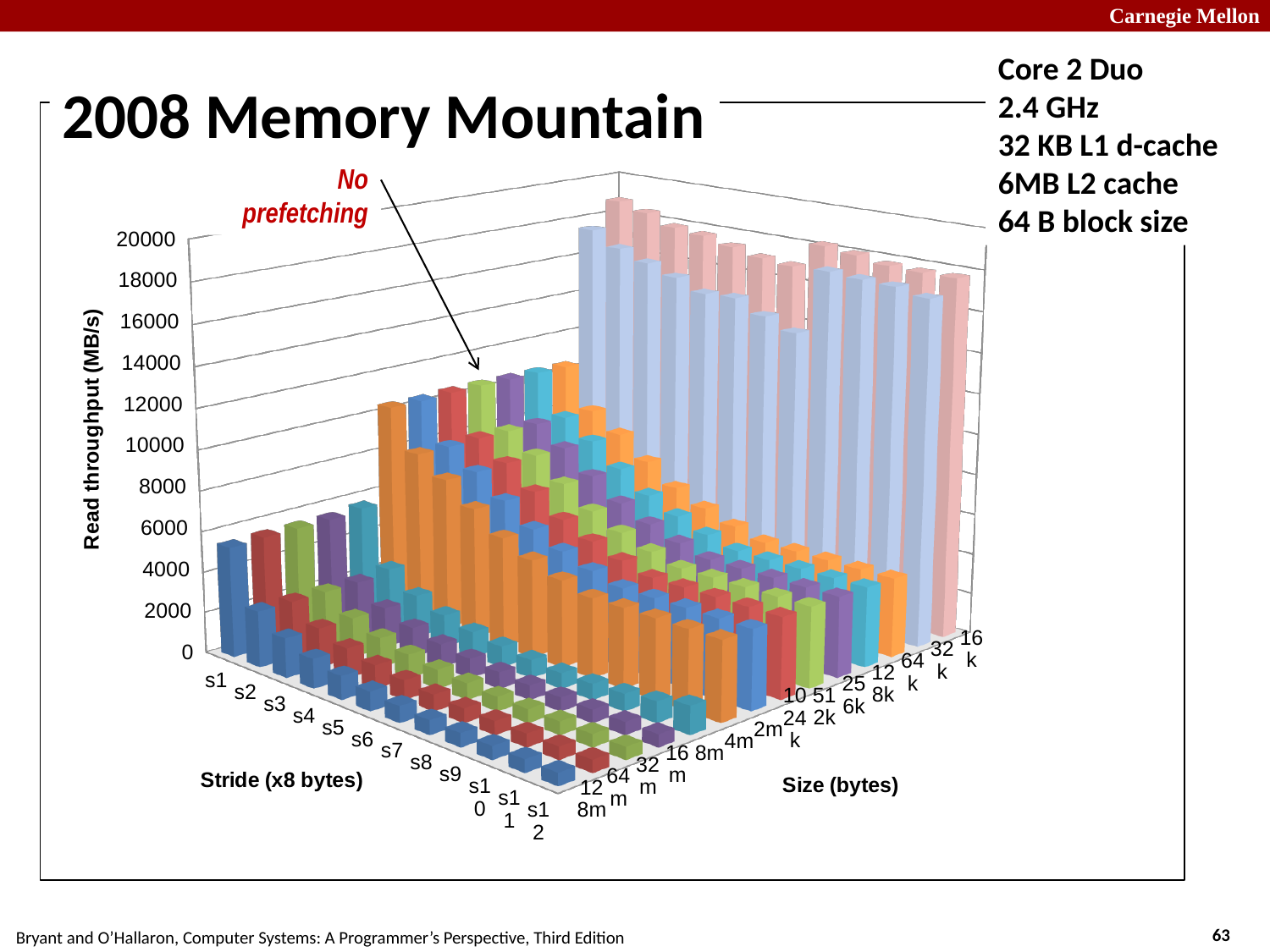
What is the lowest value shown on the Read throughput axis? 0 How many stride categories are shown along the Stride (x8 bytes) axis? 12 What is the title of the chart? 2008 Memory Mountain What is the highest value shown on the Read throughput axis? 20000 Which stride has the highest read throughput for the 16k size? s1 What type of chart is shown on the slide? 3D bar chart Is the read throughput for the 16k size at stride s1 greater or less than 16000? greater For the largest working-set sizes (front rows), does read throughput rise or fall as stride increases from s1 to s12? fall Is the read throughput for the 128m size at stride s12 greater or less than 4000? less At stride s1, is read throughput higher for the 16k size or the 128m size? 16k What is the label of the vertical axis? Read throughput (MB/s)